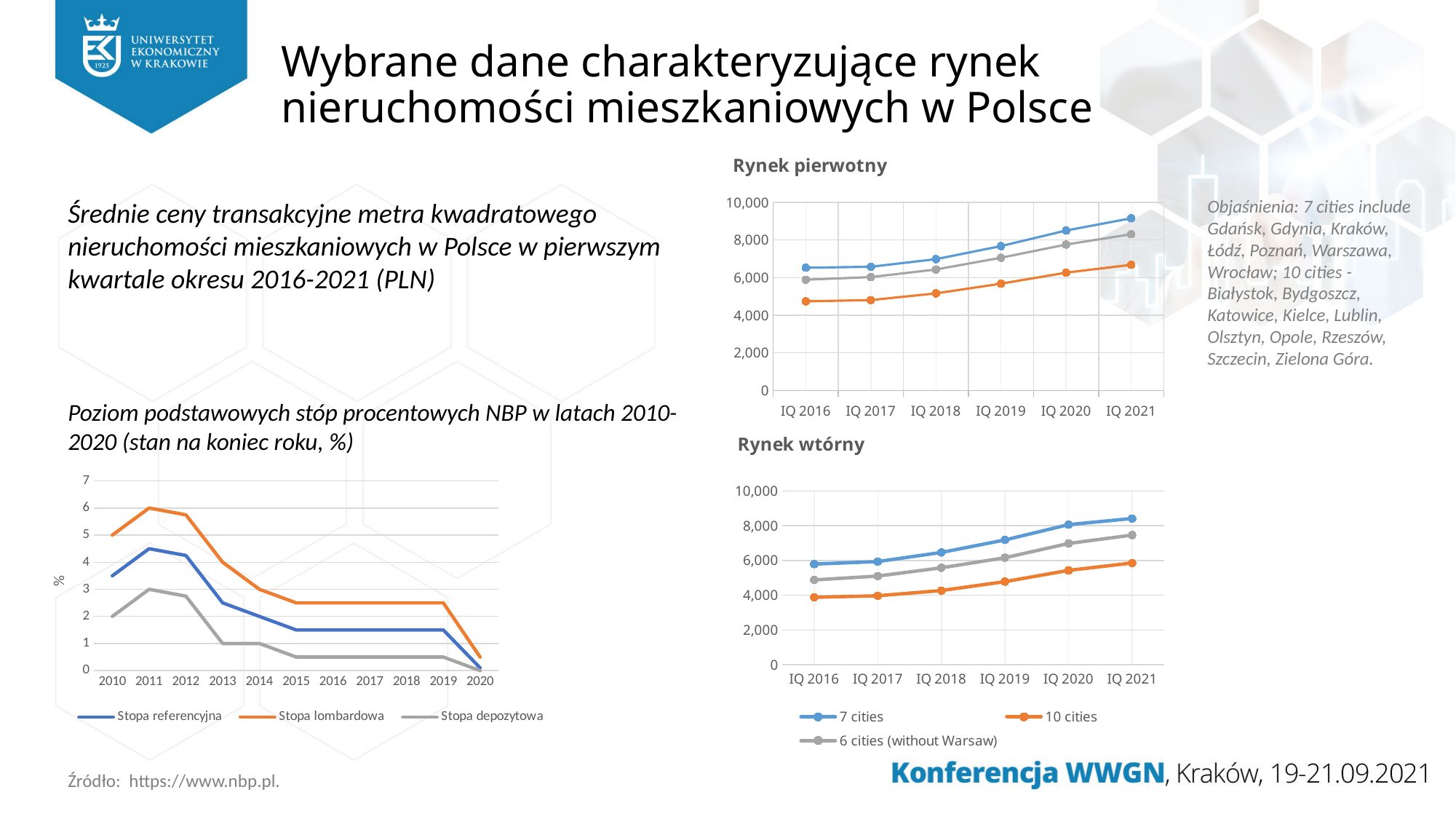
On the NBP interest rates chart (bottom left), what kind of chart is it? line chart On the NBP interest rates chart (bottom left), do the rates generally rise or fall between 2011 and 2020? fall On the Rynek wtórny chart, is the value for 6 cities (without Warsaw) in IQ 2021 greater or less than 8,000? less On the NBP interest rates chart (bottom left), how many years are shown on the x axis? 11 On the NBP interest rates chart (bottom left), is the value of Stopa referencyjna in 2015 greater or less than 2? less On the Rynek pierwotny chart, which is larger in IQ 2021: 7 cities or 10 cities? 7 cities On the NBP interest rates chart (bottom left), how many series does the legend list? 3 On the NBP interest rates chart (bottom left), in which year is Stopa lombardowa highest? 2011 On the NBP interest rates chart (bottom left), is the value of Stopa lombardowa in 2011 greater or less than 5? greater On the Rynek wtórny chart, which series has the lowest values across all quarters? 10 cities